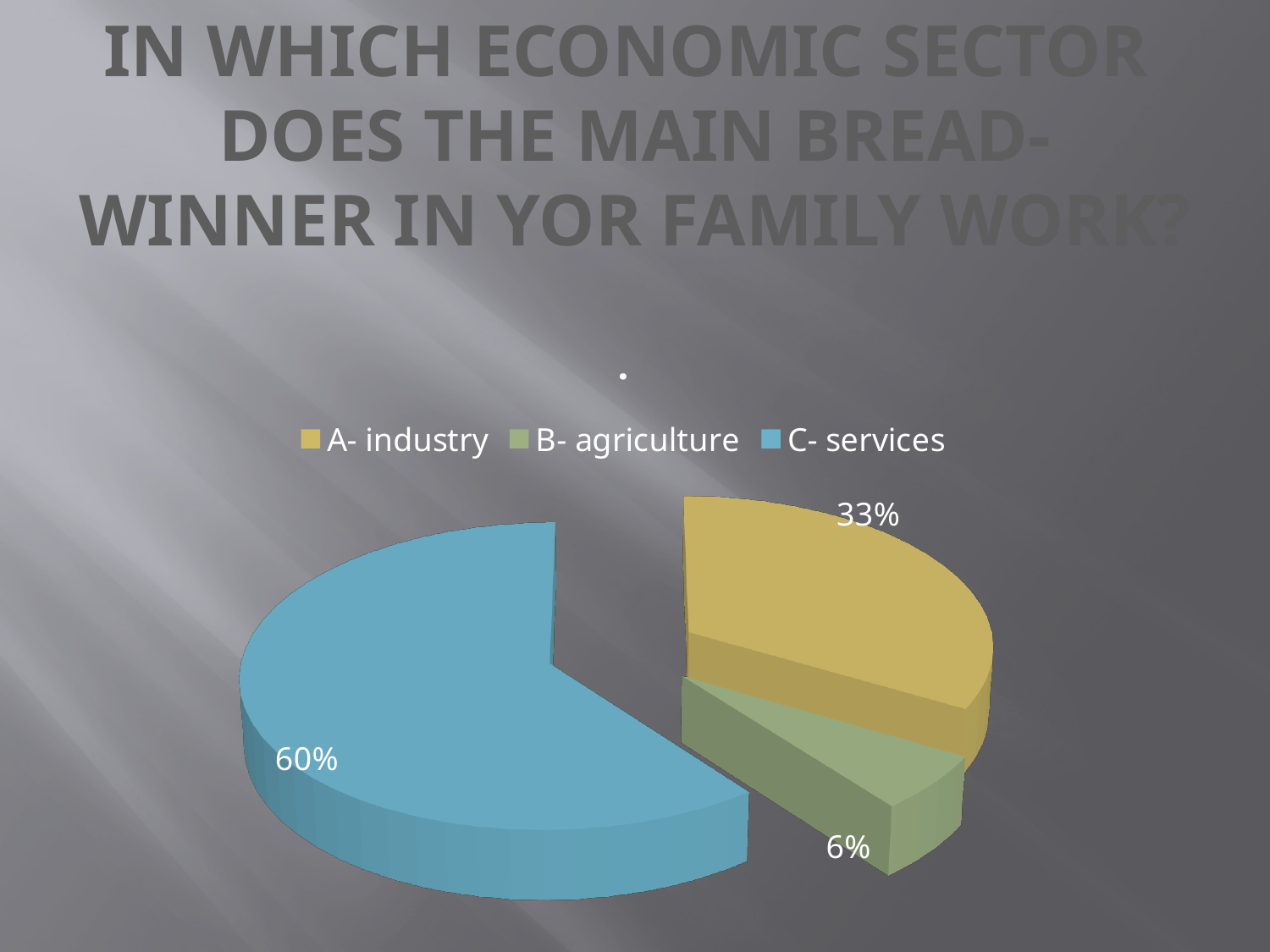
What kind of chart is shown on the slide? Pie chart What is the difference in percentage points between C- services and A- industry? 27 What is the difference in percentage points between A- industry and B- agriculture? 27 Which is larger, the slice for A- industry or the slice for B- agriculture? A- industry How many entries does the legend list? 3 What percentage of the pie is labelled for C- services? 60% What percentage of the pie is labelled for A- industry? 33% Which sector has the largest slice of the pie? C- services What percentage of the pie is labelled for B- agriculture? 6% What colour is the slice for C- services? Blue How many slices does the pie chart have? 3 Which sector has the smallest slice of the pie? B- agriculture